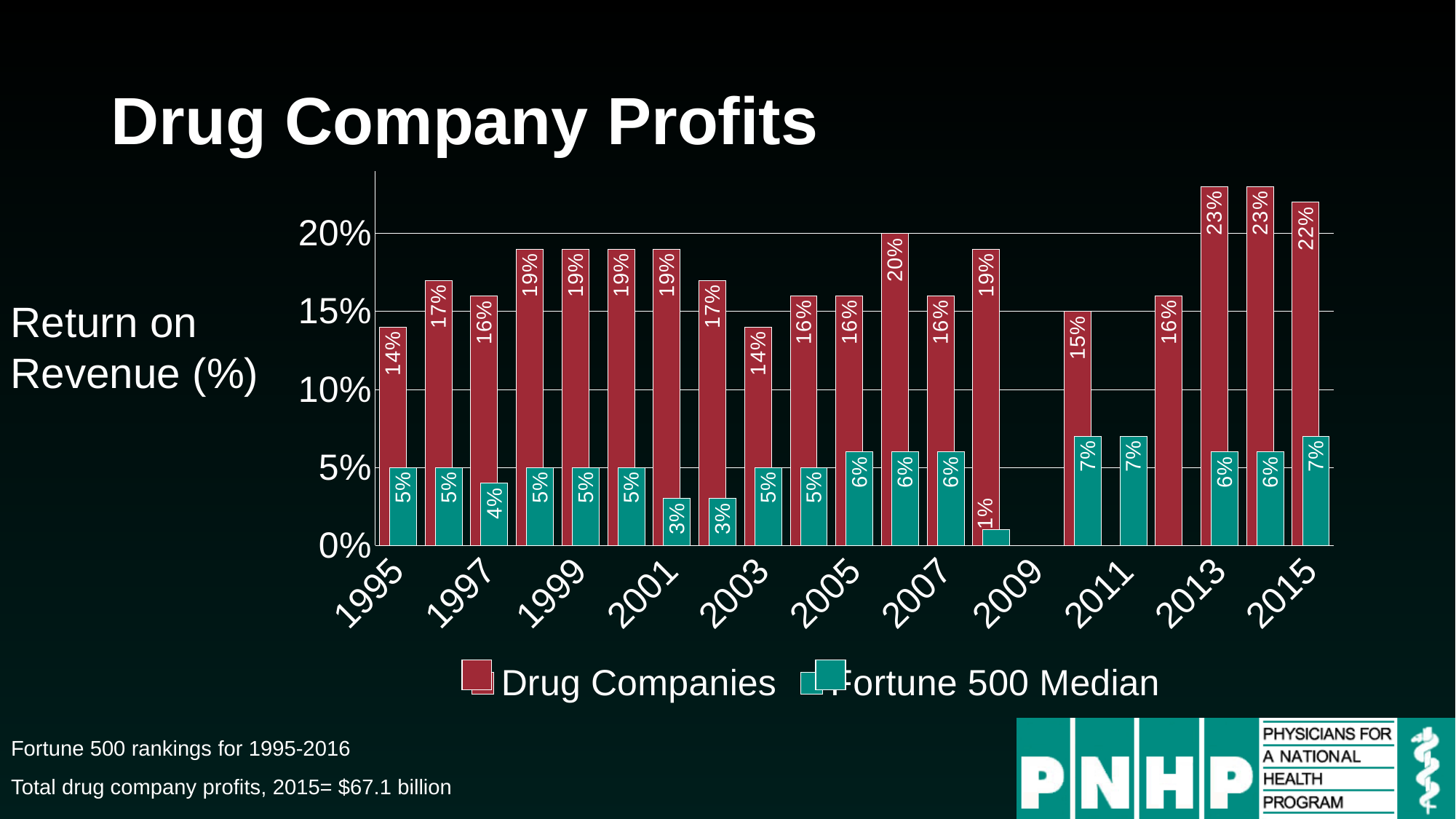
Is the Drug Companies return on revenue in 2013 greater or less than 20%? greater What was the Fortune 500 Median return on revenue in 2015? 7% In 2015, how many percentage points higher was the Drug Companies return on revenue than the Fortune 500 Median? 15 percentage points What is the lowest Fortune 500 Median value shown on the chart? 1% Which year had a higher return on revenue for Drug Companies, 1995 or 2013? 2013 What was the return on revenue for Drug Companies in 2001? 19% What was the return on revenue for Drug Companies in 2015? 22% What is the highest return on revenue shown for Drug Companies? 23% How many series does the legend list? 2 What was the return on revenue for Drug Companies in 1995? 14% What kind of chart is shown on the slide? Bar chart What was the Fortune 500 Median return on revenue in 1997? 4%